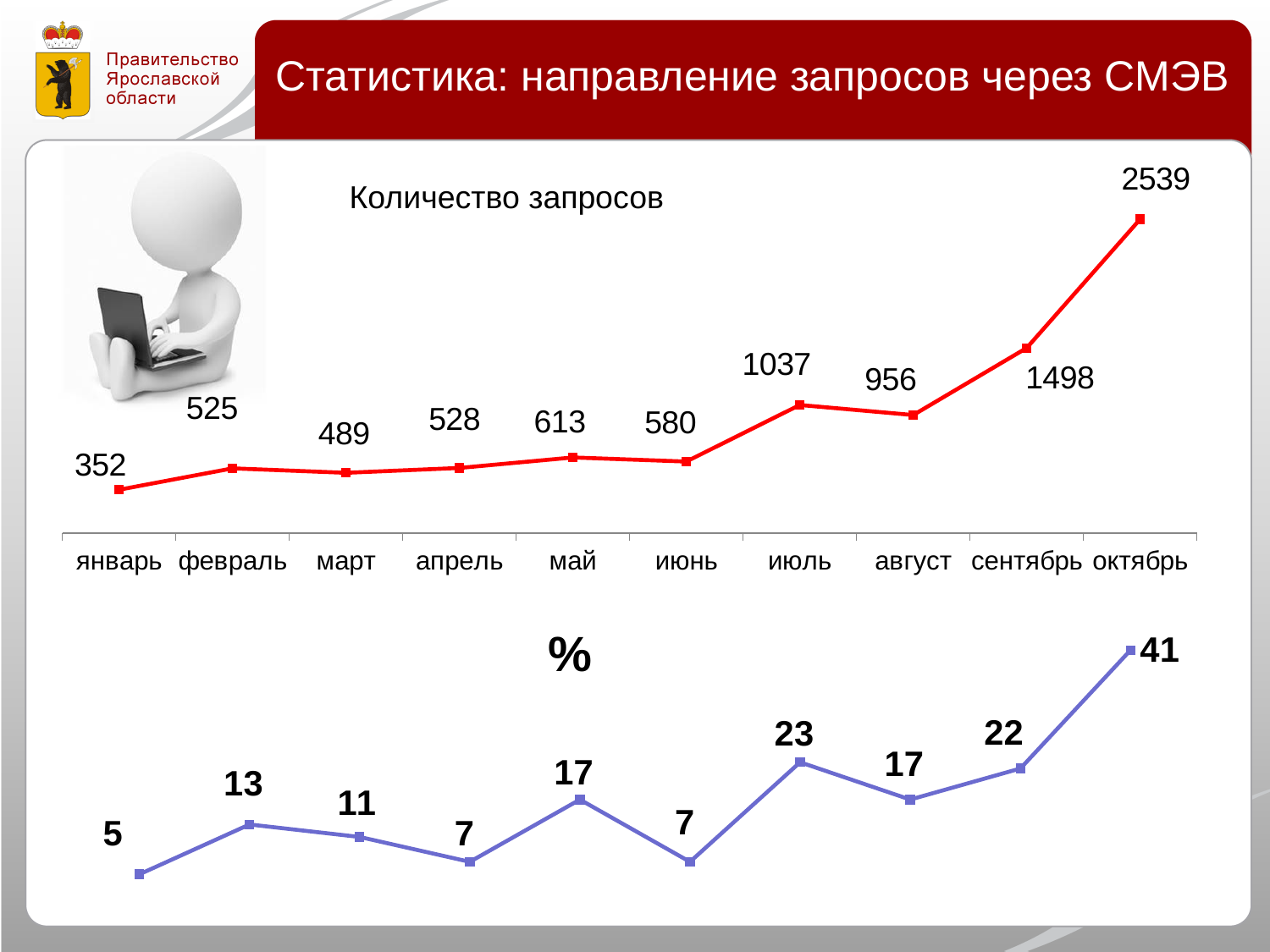
In the 'Количество запросов' chart, which month has the lowest value? январь In the '%' chart, which month has the highest value? октябрь In the 'Количество запросов' chart, what is the value for январь? 352 In the 'Количество запросов' chart, which month has the highest value? октябрь In the 'Количество запросов' chart, what is the value for июль? 1037 In the 'Количество запросов' chart, what is the difference between the values for октябрь and сентябрь? 1041 How many months are plotted in the 'Количество запросов' chart? 10 In the 'Количество запросов' chart, which is larger, the value for май or the value for июнь? май In the '%' chart, what is the value for сентябрь? 22 What type of chart is the 'Количество запросов' chart? line chart What colour is the line in the '%' chart? blue In the '%' chart, what is the difference between the values for июль and август? 6